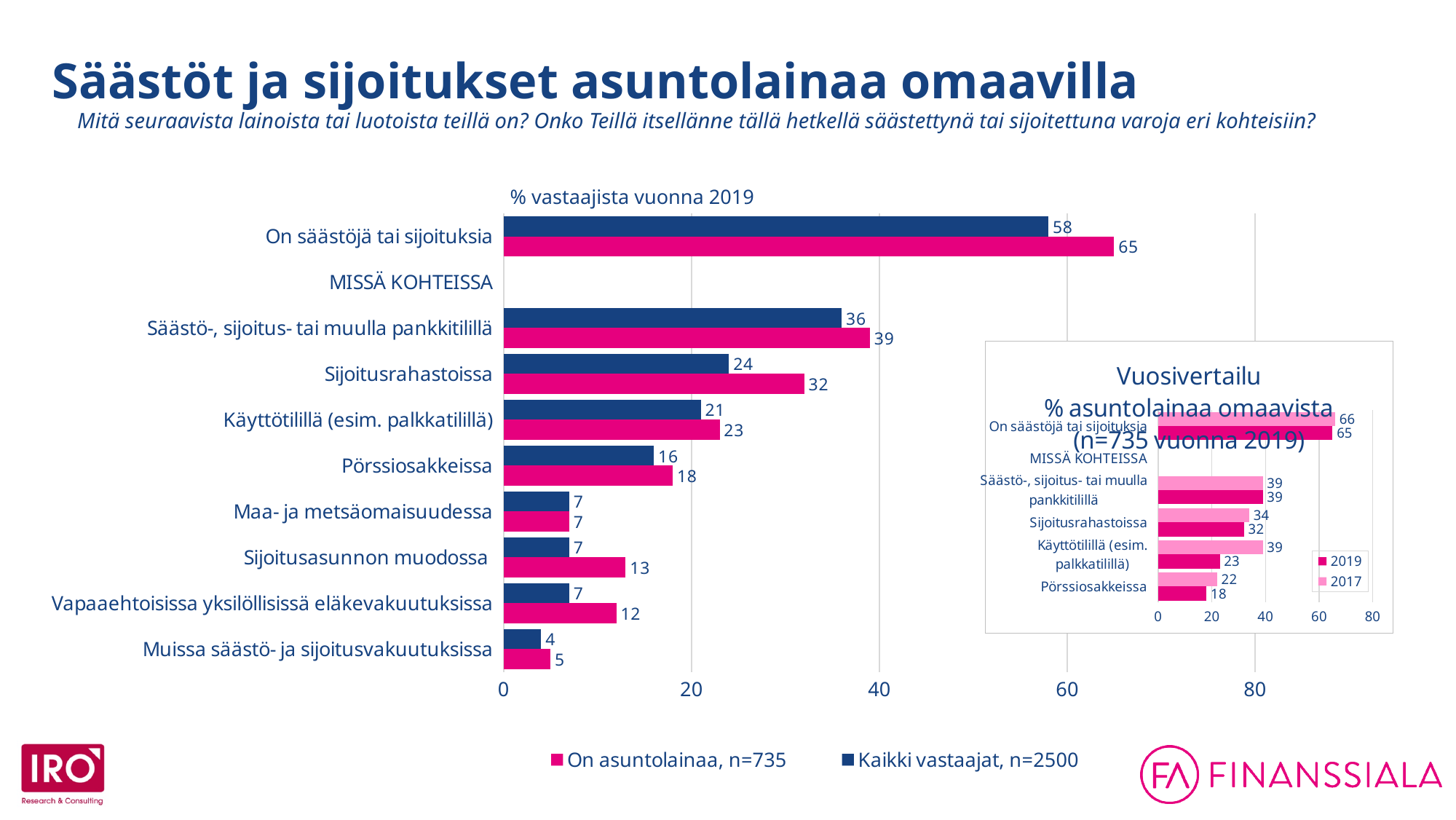
In the inset chart 'Vuosivertailu', what is the 2019 value for 'Pörssiosakkeissa'? 18 In the main chart '% vastaajista vuonna 2019', which is larger for 'Pörssiosakkeissa': 'On asuntolainaa, n=735' or 'Kaikki vastaajat, n=2500'? On asuntolainaa, n=735 In the main chart '% vastaajista vuonna 2019', what is the difference between the 'On asuntolainaa, n=735' and 'Kaikki vastaajat, n=2500' values for 'Sijoitusrahastoissa'? 8 What kind of chart is the main chart '% vastaajista vuonna 2019'? Bar chart In the main chart '% vastaajista vuonna 2019', what is the value for 'On asuntolainaa, n=735' in the category 'Sijoitusrahastoissa'? 32 Which two years does the legend of the inset chart 'Vuosivertailu' list? 2019 and 2017 In the inset chart 'Vuosivertailu', what is the difference between the 2017 and 2019 values for 'Käyttötilillä (esim. palkkatilillä)'? 16 How many series does the legend of the main chart '% vastaajista vuonna 2019' list? 2 In the main chart '% vastaajista vuonna 2019', what is the value for 'On asuntolainaa, n=735' in the category 'Sijoitusasunnon muodossa'? 13 In the inset chart 'Vuosivertailu', what is the 2017 value for 'Käyttötilillä (esim. palkkatilillä)'? 39 In the main chart '% vastaajista vuonna 2019', what is the value for 'Kaikki vastaajat, n=2500' in the category 'On säästöjä tai sijoituksia'? 58 In the main chart '% vastaajista vuonna 2019', which category has the lowest value for 'Kaikki vastaajat, n=2500'? Muissa säästö- ja sijoitusvakuutuksissa